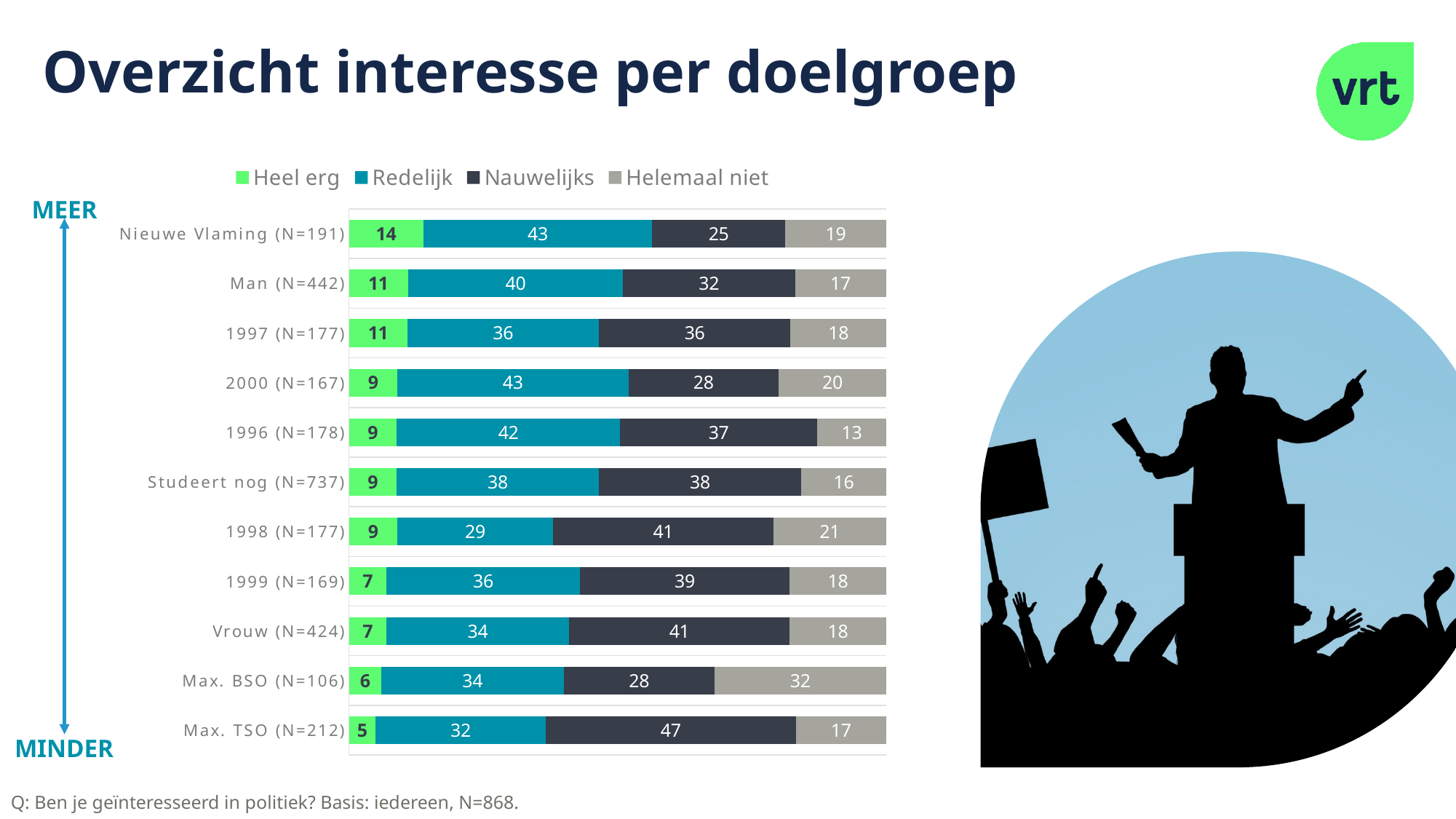
Which category has the highest 'Heel erg' value? Nieuwe Vlaming (N=191) What is the difference between the 'Redelijk' values for Nieuwe Vlaming (N=191) and 1998 (N=177)? 14 Which category has the lowest 'Heel erg' value? Max. TSO (N=212) What kind of chart is shown on the slide? Stacked bar chart What is the 'Nauwelijks' value for Max. TSO (N=212)? 47 What is the 'Helemaal niet' value for Max. BSO (N=106)? 32 Which legend entry is shown in green? Heel erg What is the total of the stacked bar for Man (N=442)? 100 How many categories are shown on the chart? 11 How many series does the legend list? 4 What is the 'Heel erg' value for Nieuwe Vlaming (N=191)? 14 Which is larger: the 'Nauwelijks' value for 1996 (N=178) or for 2000 (N=167)? 1996 (N=178)